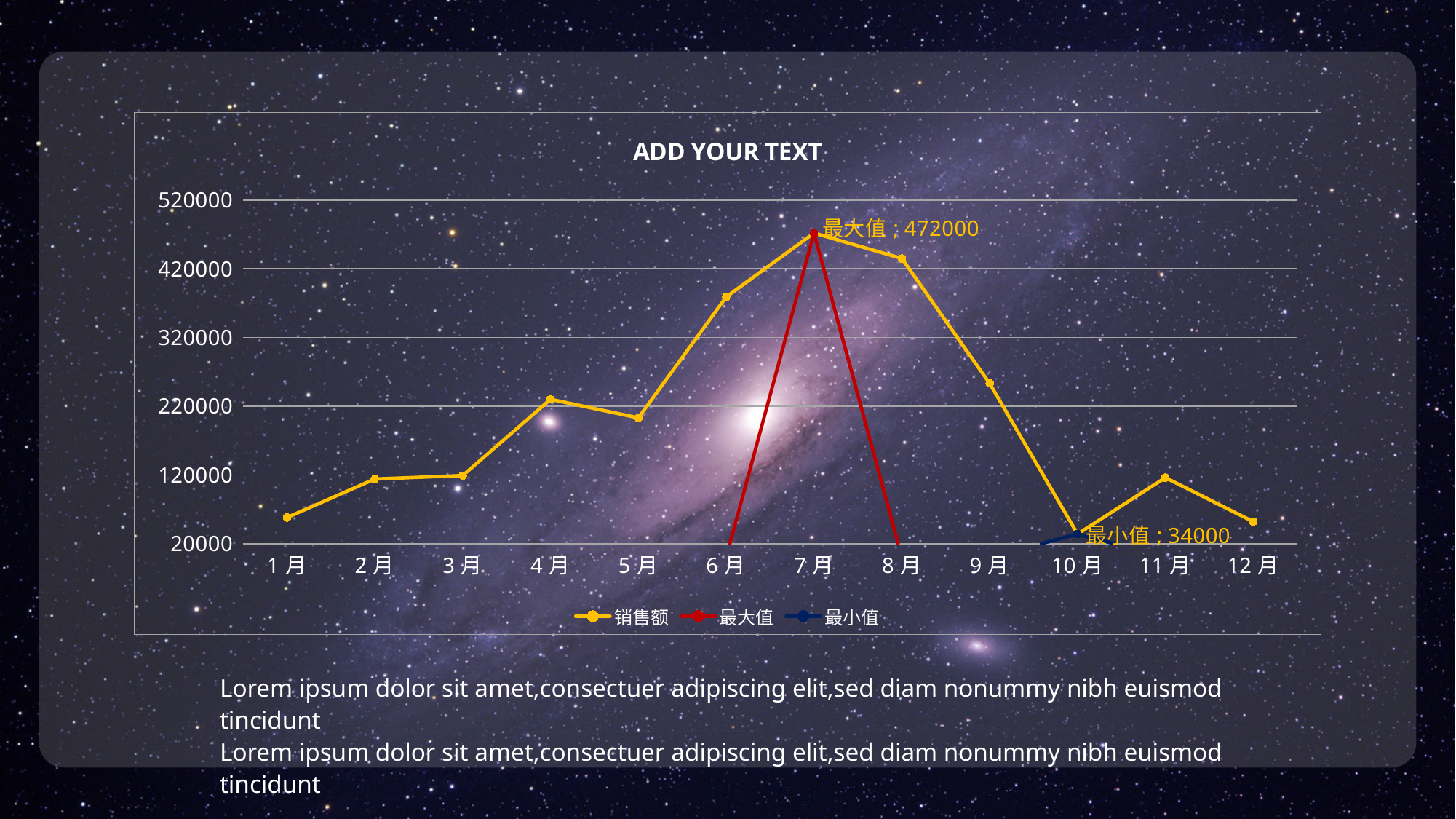
What kind of chart is shown on the slide? line chart What is the title of the chart? ADD YOUR TEXT What is the 销售额 value labelled as the maximum (最大值)? 472000 How many series does the legend list? 3 Which month has the larger 销售额 value, 6月 or 9月? 6月 What is the difference between the labelled maximum and minimum 销售额 values? 438000 How many months are shown on the x axis? 12 Which month has the highest 销售额 value? 7月 Which month has the lowest 销售额 value? 10月 Is the 销售额 value for 1月 greater or less than 120000? less Is the 销售额 value for 6月 greater or less than 320000? greater What is the 销售额 value labelled as the minimum (最小值)? 34000